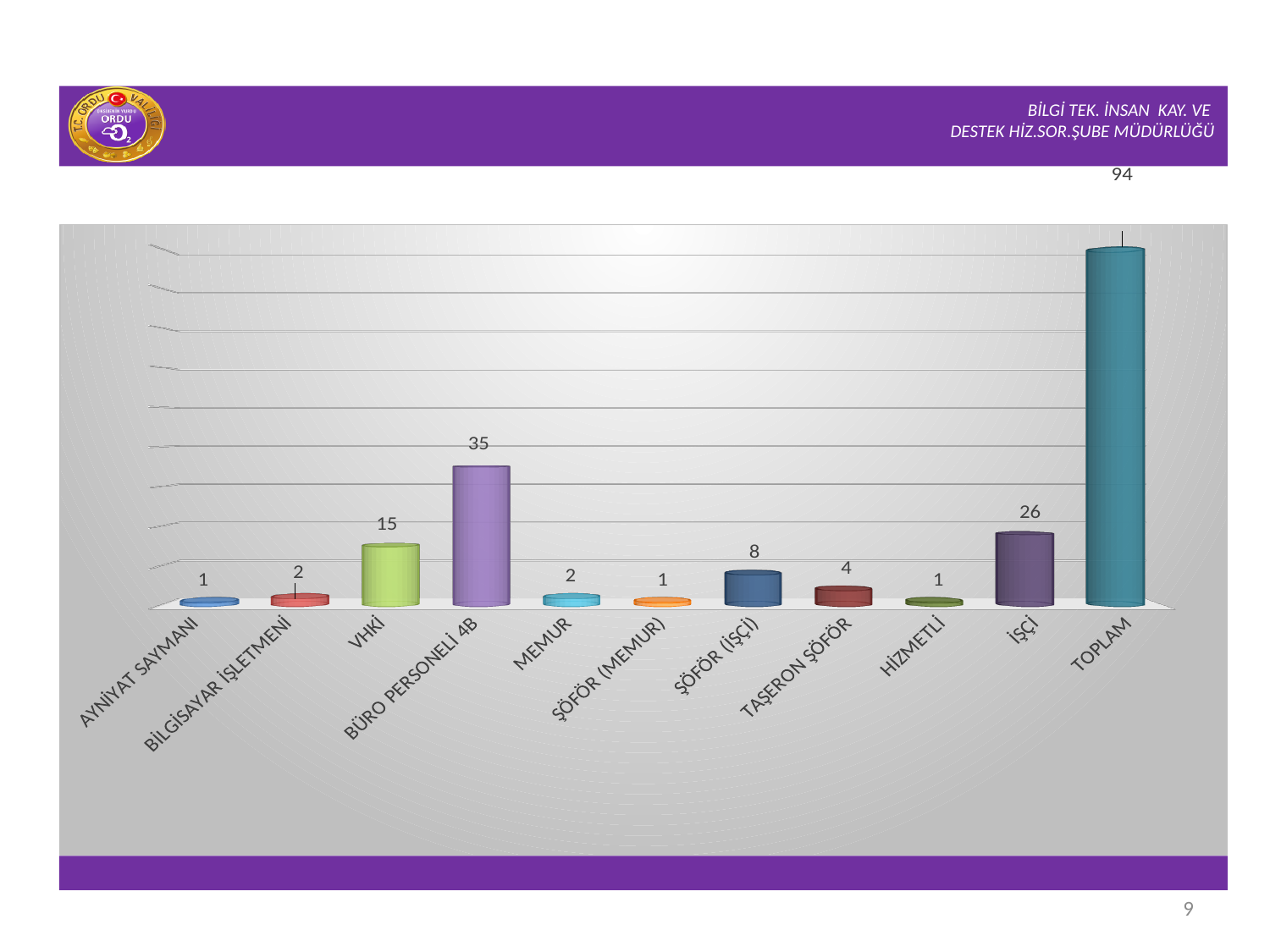
What is the value for TOPLAM? 94 What is the value for BÜRO PERSONELİ 4B? 35 Which is larger, the value for VHKİ or the value for ŞÖFÖR (İŞÇİ)? VHKİ What is the value for VHKİ? 15 What is the difference between the values for BÜRO PERSONELİ 4B and İŞÇİ? 9 What is the difference between the values for TAŞERON ŞÖFÖR and MEMUR? 2 What is the value for İŞÇİ? 26 What is the value for ŞÖFÖR (İŞÇİ)? 8 What kind of chart is shown on the slide? Bar chart How many categories are shown on the x axis? 11 Excluding TOPLAM, which category has the highest value? BÜRO PERSONELİ 4B Which category has the highest value? TOPLAM